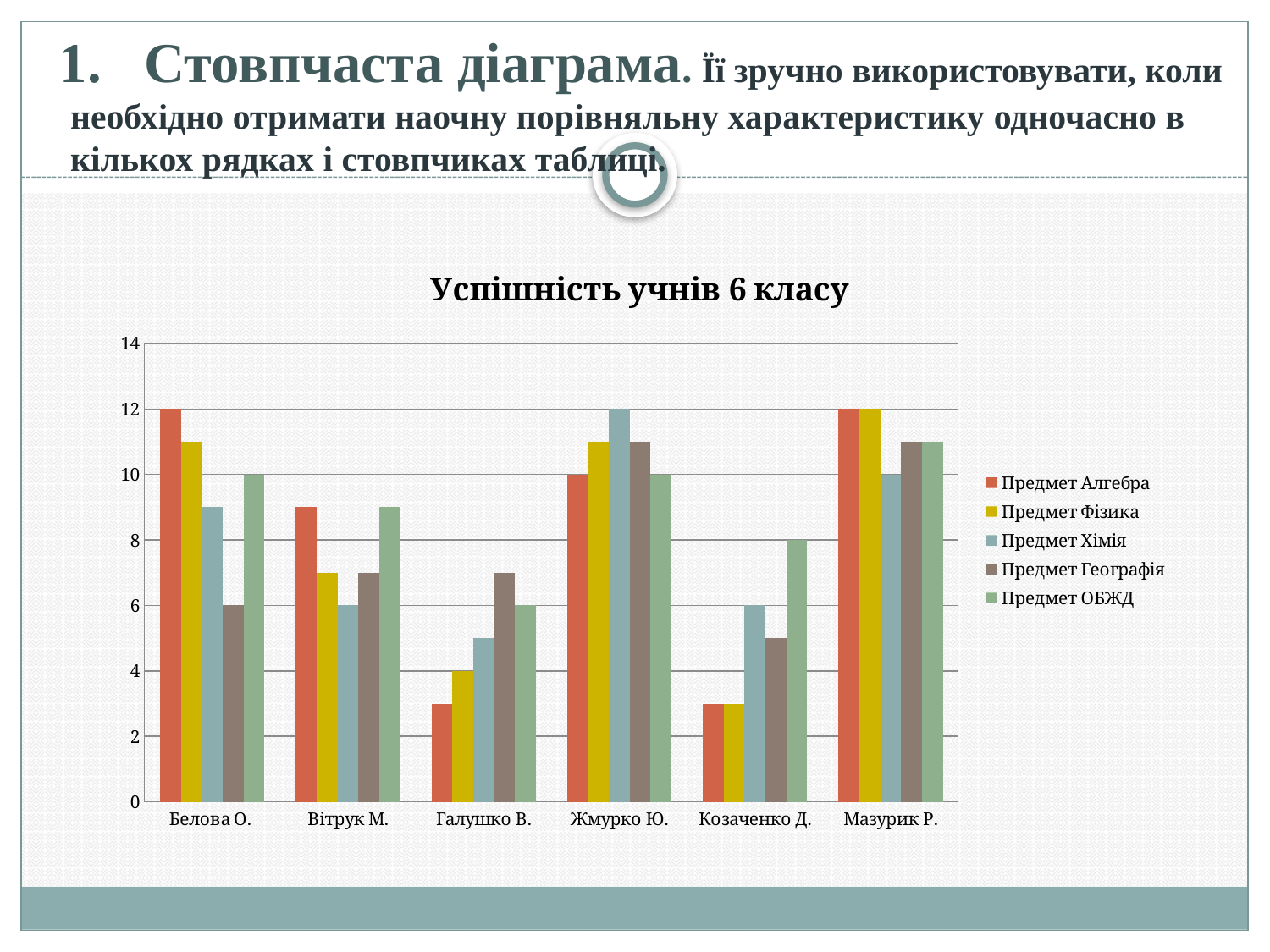
What is the difference between Предмет Алгебра and Предмет Хімія for Мазурик Р.? 2 What is the value for Предмет Хімія for Жмурко Ю.? 12 What is the value for Предмет ОБЖД for Козаченко Д.? 8 How many series does the legend list? 5 What type of chart is shown on the slide? bar chart Which student has the highest value for Предмет Хімія? Жмурко Ю. How many students (categories) are shown on the x axis? 6 What is the value for Предмет Алгебра for Белова О.? 12 Which is larger for Белова О.: Предмет Алгебра or Предмет Географія? Предмет Алгебра Is the value for Предмет Алгебра for Вітрук М. greater or less than 8? greater Which student has the lowest value for Предмет ОБЖД? Галушко В. What is the title of the chart? Успішність учнів 6 класу